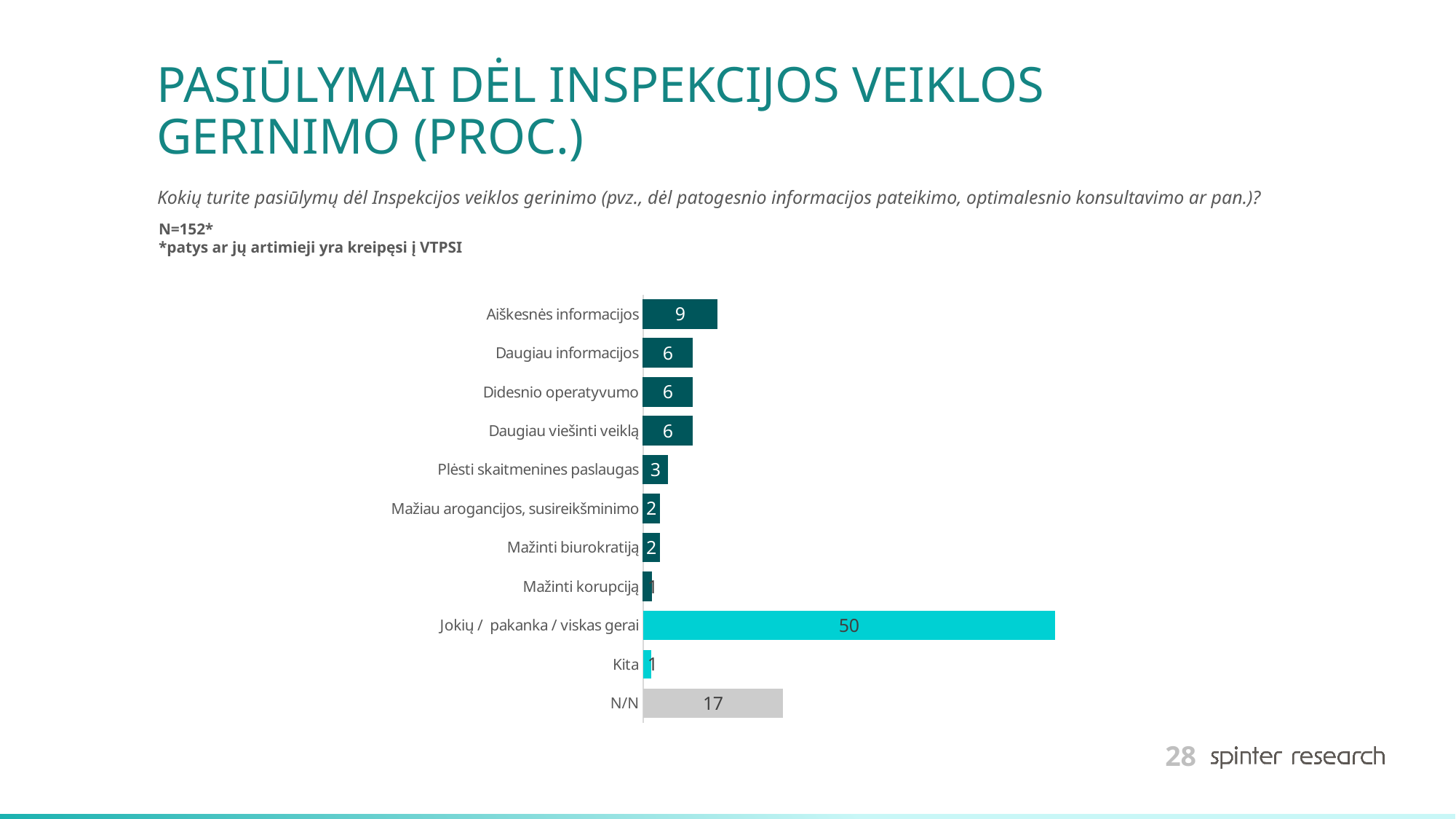
What is the value for "Mažinti korupciją"? 1 What is the value for "N/N"? 17 What is the difference between the values for "Jokių / pakanka / viskas gerai" and "N/N"? 33 How many categories are shown in the chart? 11 Which category has the highest value? Jokių / pakanka / viskas gerai What kind of chart is shown on the slide? Bar chart What is the difference between the values for "Aiškesnės informacijos" and "Daugiau informacijos"? 3 What is the value for "Jokių / pakanka / viskas gerai"? 50 What is the value for "Aiškesnės informacijos"? 9 What is the value for "Plėsti skaitmenines paslaugas"? 3 What sample size (N) is stated on the slide? N=152* Which is larger, the value for "Aiškesnės informacijos" or the value for "Mažinti biurokratiją"? Aiškesnės informacijos